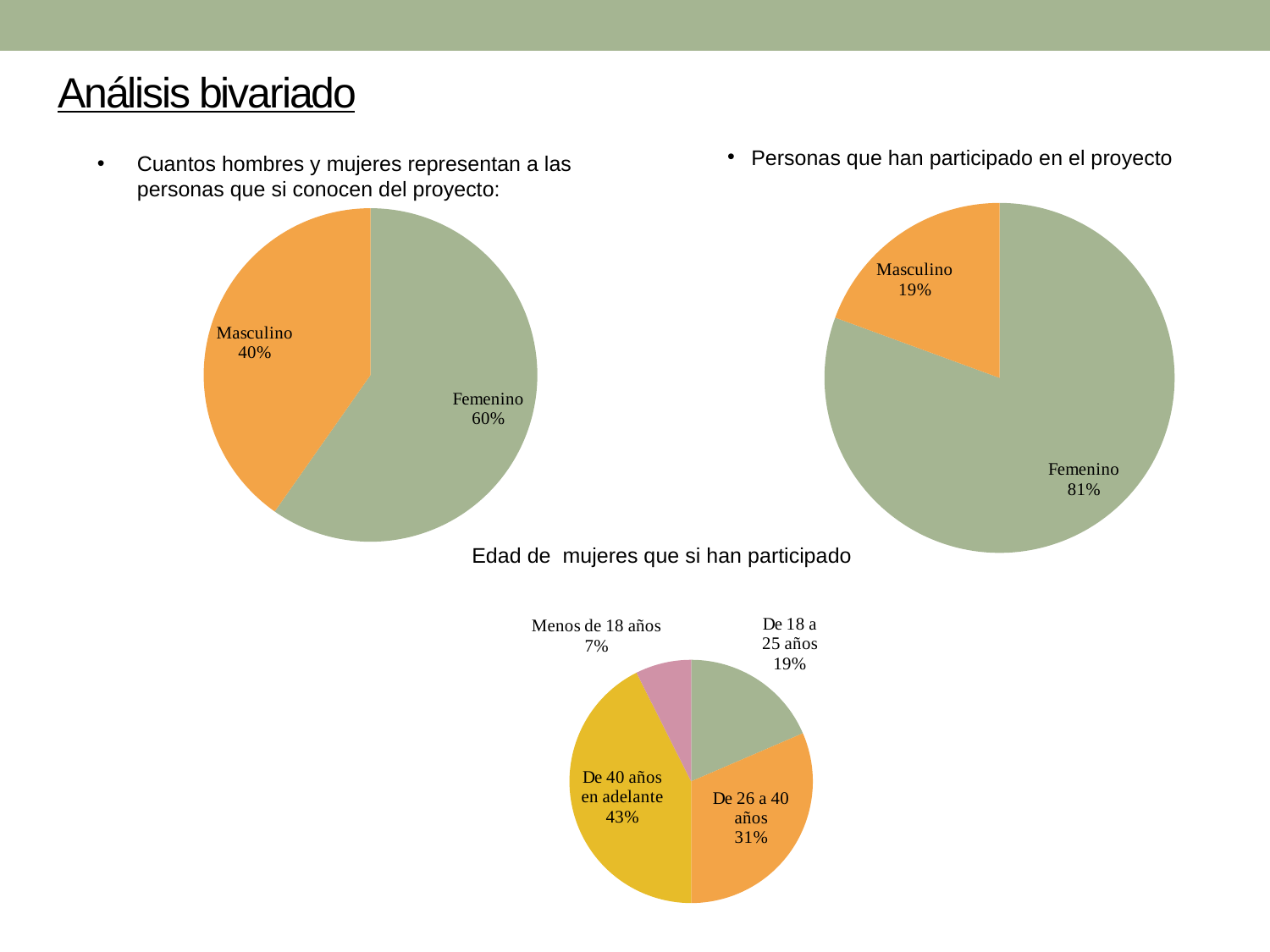
In the top-left pie chart (people who know about the project), what is the difference between the Femenino and Masculino shares? 20% In the bottom pie chart (Edad de mujeres que si han participado), how many age categories are shown? 4 In the bottom pie chart (Edad de mujeres que si han participado), which age group has the largest slice? De 40 años en adelante In the bottom pie chart (Edad de mujeres que si han participado), what share is De 26 a 40 años? 31% In the top-right pie chart (people who have participated in the project), what share is Masculino? 19% In the bottom pie chart (Edad de mujeres que si han participado), which is larger: De 18 a 25 años or De 26 a 40 años? De 26 a 40 años In the top-right pie chart (people who have participated in the project), what is the difference between the Femenino and Masculino shares? 62% In the top-left pie chart (people who know about the project), what share is Femenino? 60% In the bottom pie chart (Edad de mujeres que si han participado), which age group has the smallest slice? Menos de 18 años What type of chart is the top-left chart (people who know about the project)? Pie chart In the top-right pie chart (people who have participated in the project), which category has the largest slice? Femenino